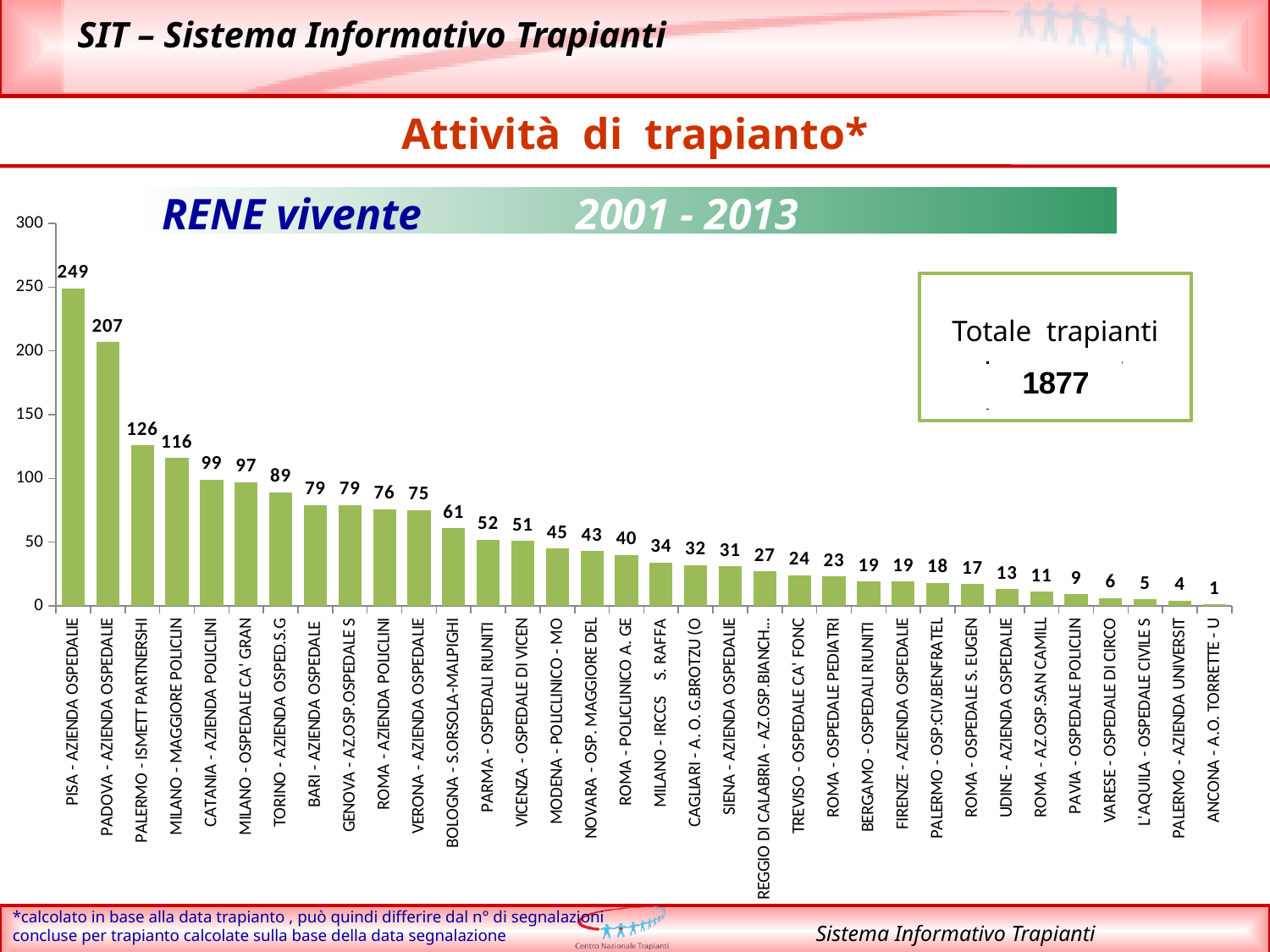
What kind of chart is shown on the slide? Bar chart What total number of transplants (Totale trapianti) is shown in the box on the chart? 1877 Which category has the highest value? PISA - AZIENDA OSPEDALE What is the difference between the values for PISA - AZIENDA OSPEDALE and PADOVA - AZIENDA OSPEDALE? 42 How many categories (hospitals) are shown in the chart? 34 Which is larger, the value for CATANIA - AZIENDA POLICLINI or the value for TORINO - AZIENDA OSPED.S.G? CATANIA - AZIENDA POLICLINI Which category has the lowest value? ANCONA - A.O. TORRETTE - U What is the value for BOLOGNA - S.ORSOLA-MALPIGHI? 61 Do the values rise or fall from left to right along the x axis? Fall What is the value for PISA - AZIENDA OSPEDALE? 249 What period does the chart cover, according to its title? 2001 - 2013 What is the value for TREVISO - OSPEDALE CA' FONC? 24